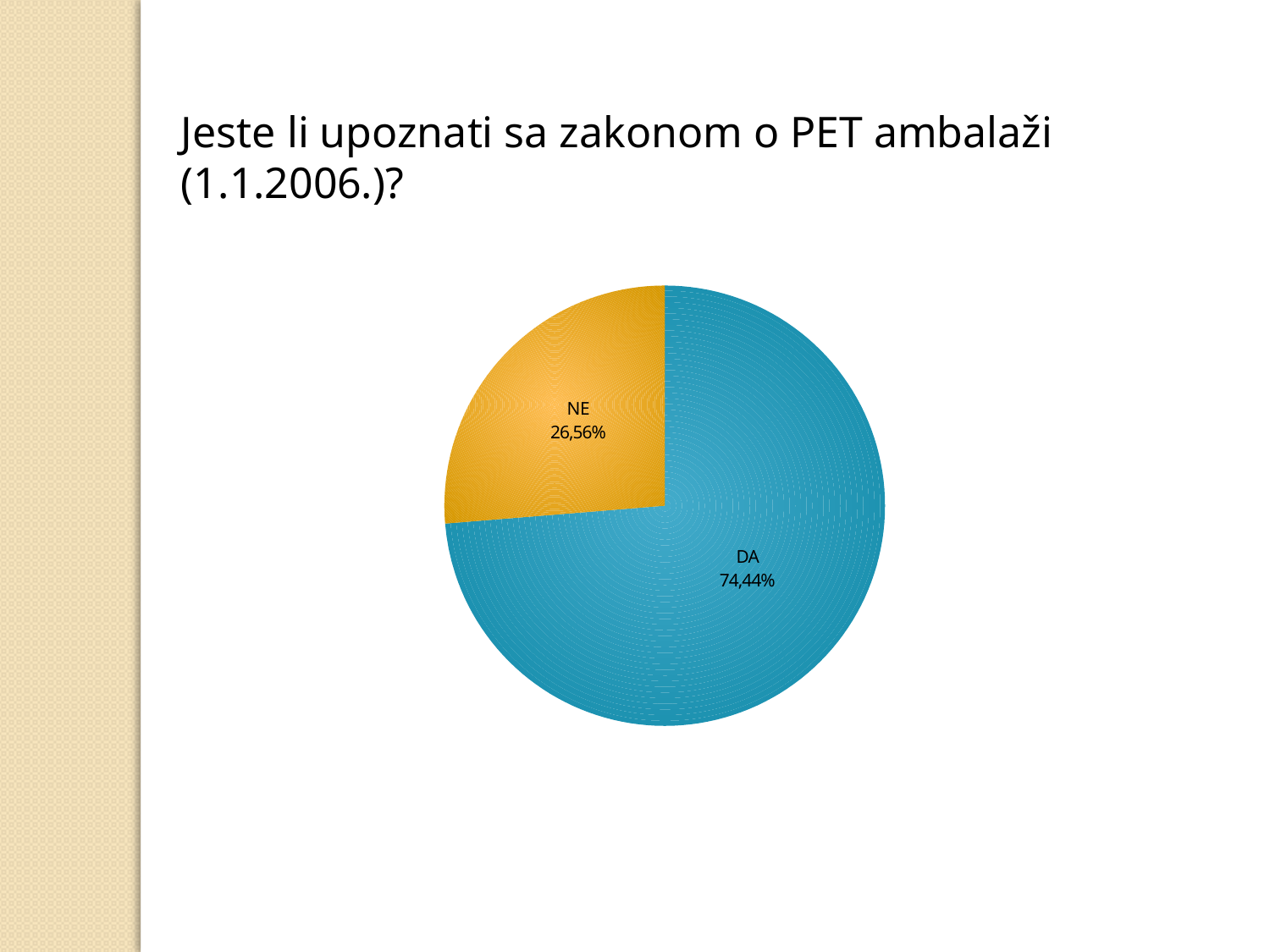
What share of the pie does the NE slice represent? 26,56% What percentage is shown for the NE slice? 26,56% Which is larger, the DA slice or the NE slice? DA Which slice of the pie is the largest? DA How many slices does the pie chart have? 2 Which slice of the pie is the smallest? NE What percentage is shown for the DA slice? 74,44% What colour is the DA slice? blue What colour is the NE slice? orange What kind of chart is shown on the slide? pie chart What is the difference between the DA and NE percentages? 47,88%